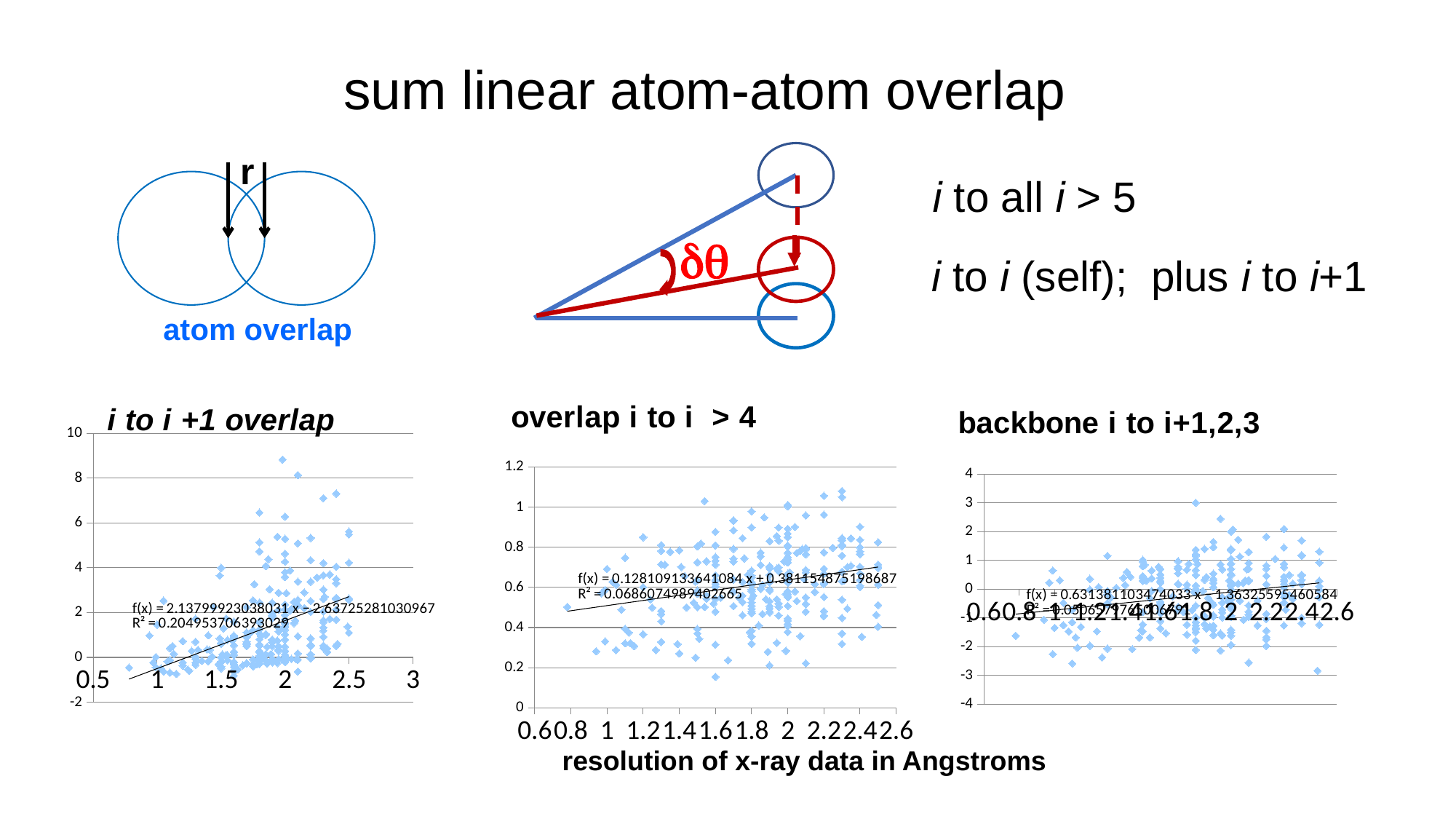
What kind of chart is the "i to i +1 overlap" chart? scatter chart In the "i to i +1 overlap" chart, what is the R² value printed for the trendline? 0.204953706393029 What is the x-axis label on the "overlap i to i > 4" chart? resolution of x-ray data in Angstroms In the "overlap i to i > 4" chart, does the fitted trendline rise or fall as resolution increases along the x axis? rise In the "i to i +1 overlap" chart, does the fitted trendline rise or fall along the x axis? rise What is the trendline equation printed on the "i to i +1 overlap" chart? f(x) = 2.13799923038031 x − 2.63725281030967 How many charts are shown on the slide? 3 What is the trendline equation printed on the "backbone i to i+1,2,3" chart? f(x) = 0.631381103474033 x − 1.36325595460584 What is the trendline equation printed on the "overlap i to i > 4" chart? f(x) = 0.128109133641084 x + 0.381154875198687 What is the maximum value shown on the y axis of the "overlap i to i > 4" chart? 1.2 Which chart has the larger R² value for its trendline, "i to i +1 overlap" or "overlap i to i > 4"? i to i +1 overlap In the "overlap i to i > 4" chart, what is the R² value printed for the trendline? 0.0686074989402665